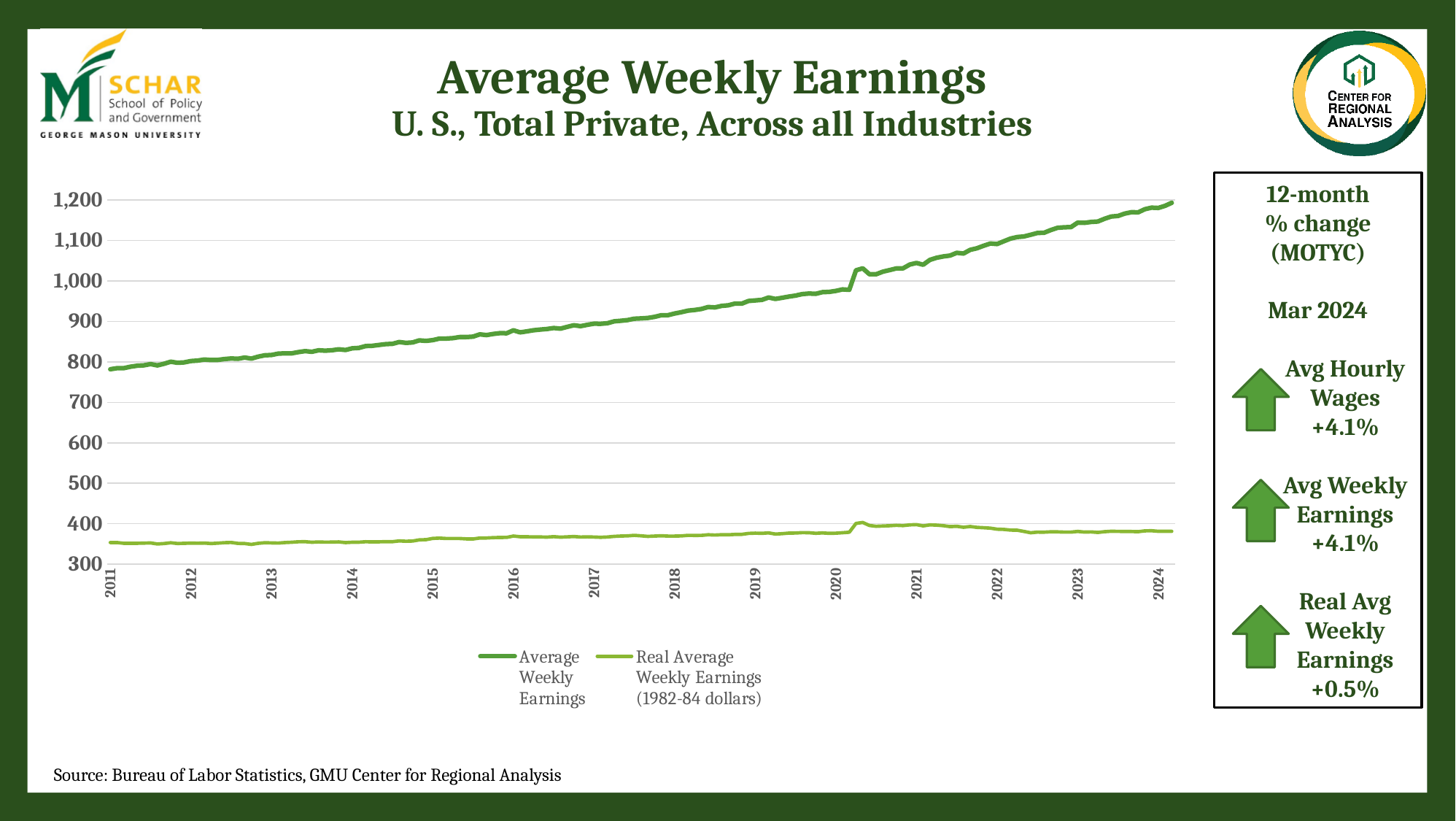
Does the Average Weekly Earnings line rise or fall from 2011 to 2024? rise According to the side panel, what is the 12-month % change in Avg Hourly Wages for Mar 2024? +4.1% According to the side panel, what is the 12-month % change in Real Avg Weekly Earnings for Mar 2024? +0.5% Is the value for Average Weekly Earnings in 2024 greater or less than 1,100? greater What is the subtitle of the chart? U. S., Total Private, Across all Industries Is the value for Real Average Weekly Earnings (1982-84 dollars) in 2024 greater or less than 400? less How many year labels are shown on the x axis? 14 Is the value for Average Weekly Earnings in 2011 greater or less than 800? less How many series does the legend list? 2 What kind of chart is shown on the slide? line chart In 2024, which series is higher: Average Weekly Earnings or Real Average Weekly Earnings (1982-84 dollars)? Average Weekly Earnings